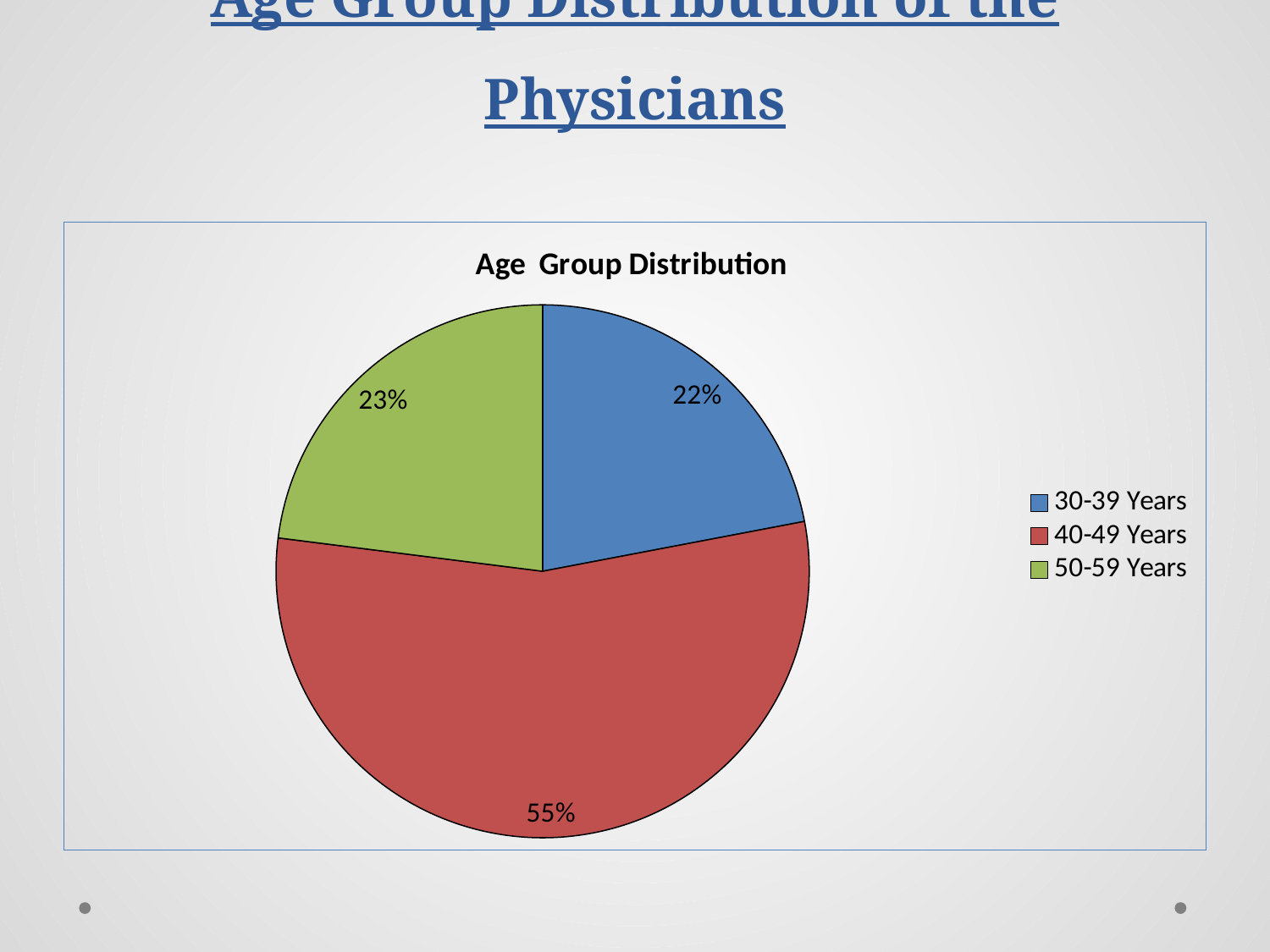
What kind of chart is shown on the slide? pie chart What share of the pie is the 30-39 Years slice? 22% What is the chart's title? Age Group Distribution What share of the pie is the 50-59 Years slice? 23% Which is larger, the 50-59 Years slice or the 30-39 Years slice? 50-59 Years Which age group has the largest share of the pie? 40-49 Years How many slices does the pie chart have? 3 What is the difference in percentage points between the 40-49 Years slice and the 50-59 Years slice? 32 What colour is the 40-49 Years slice? red How many entries does the legend list? 3 What share of the pie is the 40-49 Years slice? 55% Which age group has the smallest share of the pie? 30-39 Years